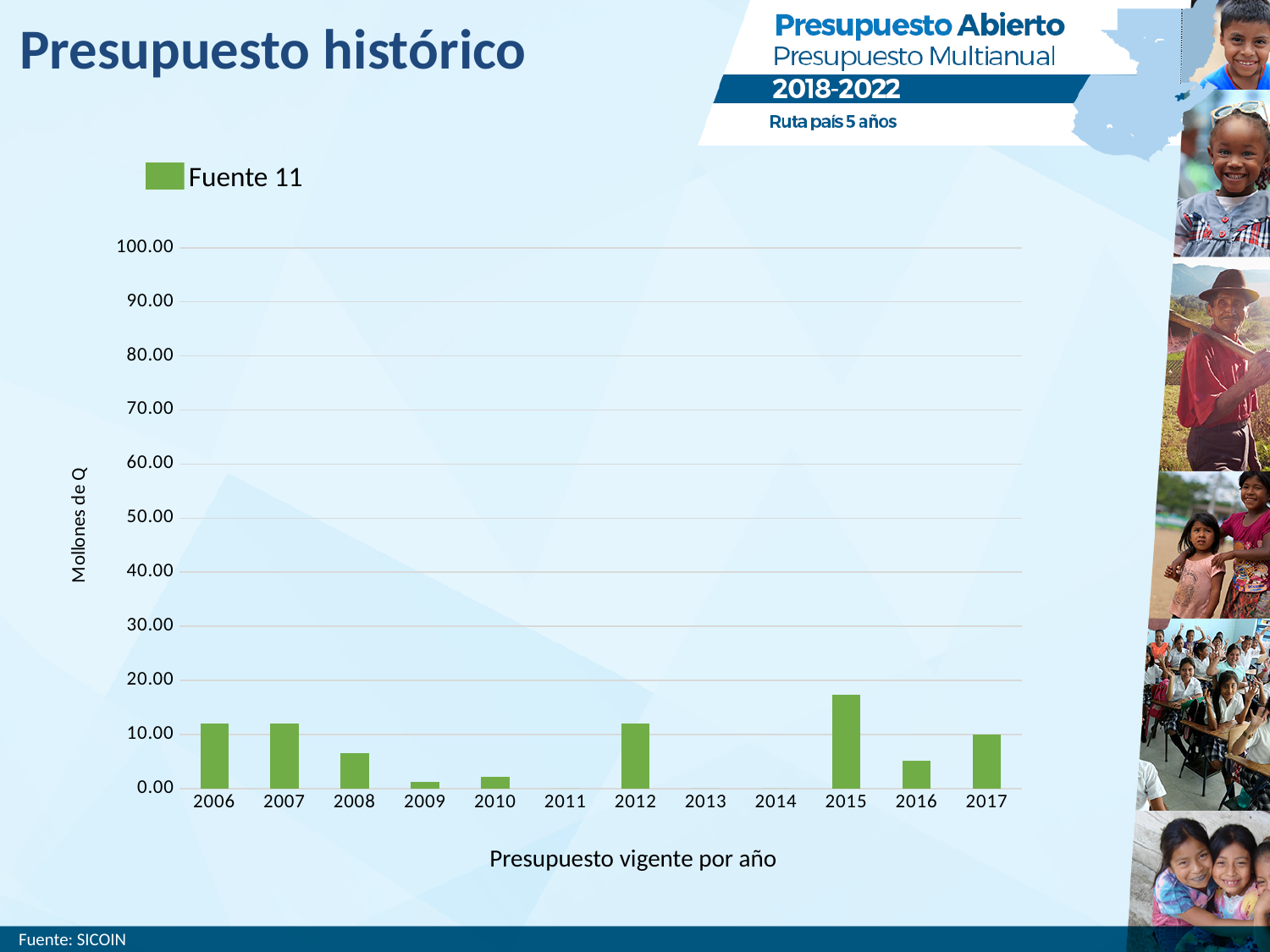
Which year has the highest value in the chart? 2015 Which year has the larger value, 2015 or 2016? 2015 What is the title of the chart's x axis? Presupuesto vigente por año Is the value for 2006 greater or less than 20.00? less Is the value for 2015 greater or less than 10.00? greater What is the name of the series shown in the chart's legend? Fuente 11 Is the value for 2008 greater or less than 10.00? less How many series does the chart's legend list? 1 How many years are shown on the x axis of the chart? 12 Which year has the larger value, 2008 or 2009? 2008 What kind of chart is shown on the slide? bar chart